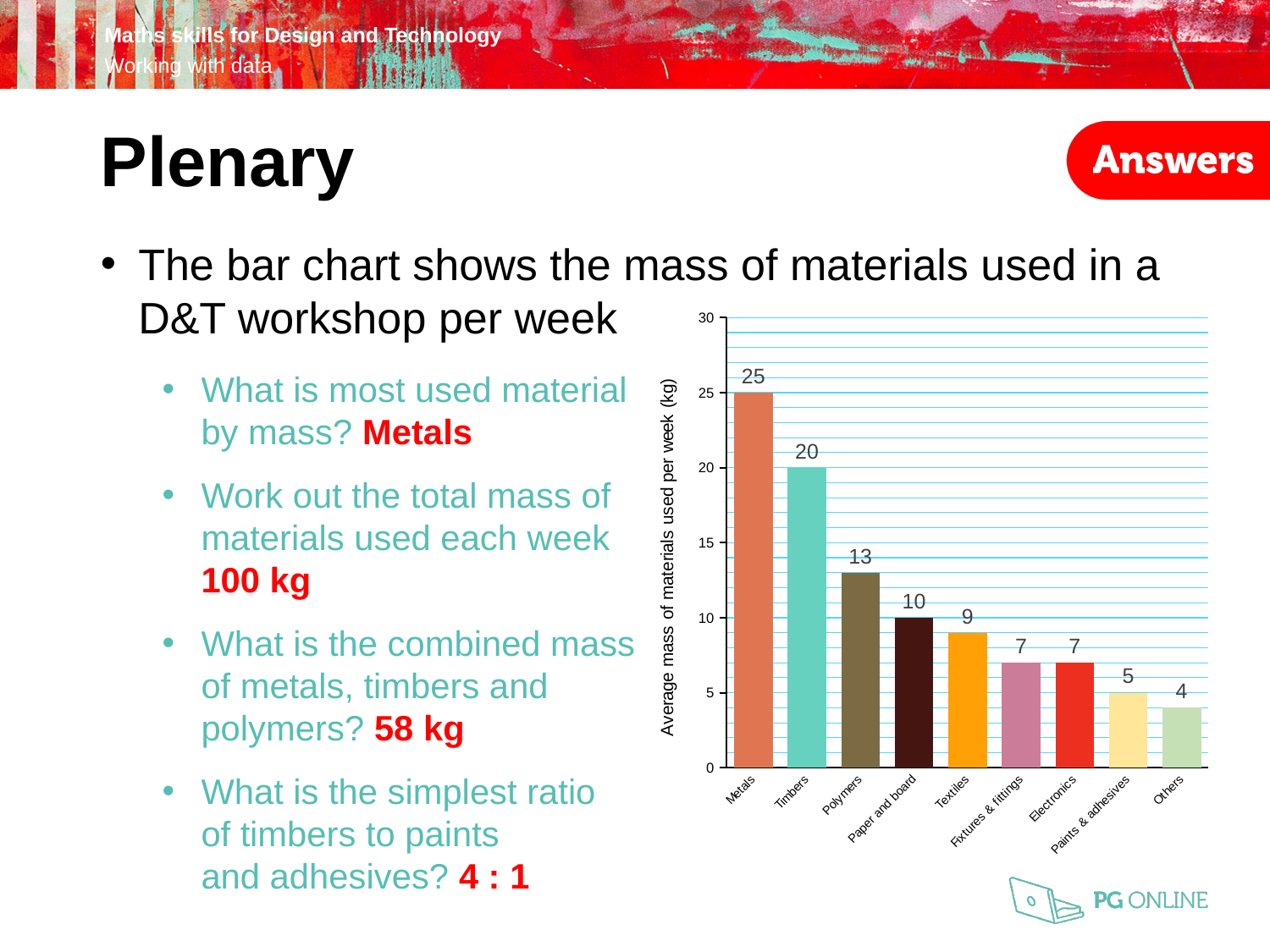
Is the value for Timbers greater or less than 15? greater Which category has the highest value? Metals What is the value for Metals? 25 How many categories are shown on the x axis? 9 What is the difference between the values for Timbers and Textiles? 11 What is the label of the y axis? Average mass of materials used per week (kg) Do the values rise or fall from left to right along the x axis? fall What is the value for Polymers? 13 Which category has the lowest value? Others What kind of chart is shown on the slide? bar chart Which is larger, the value for Paper and board or the value for Electronics? Paper and board What is the value for Paints & adhesives? 5